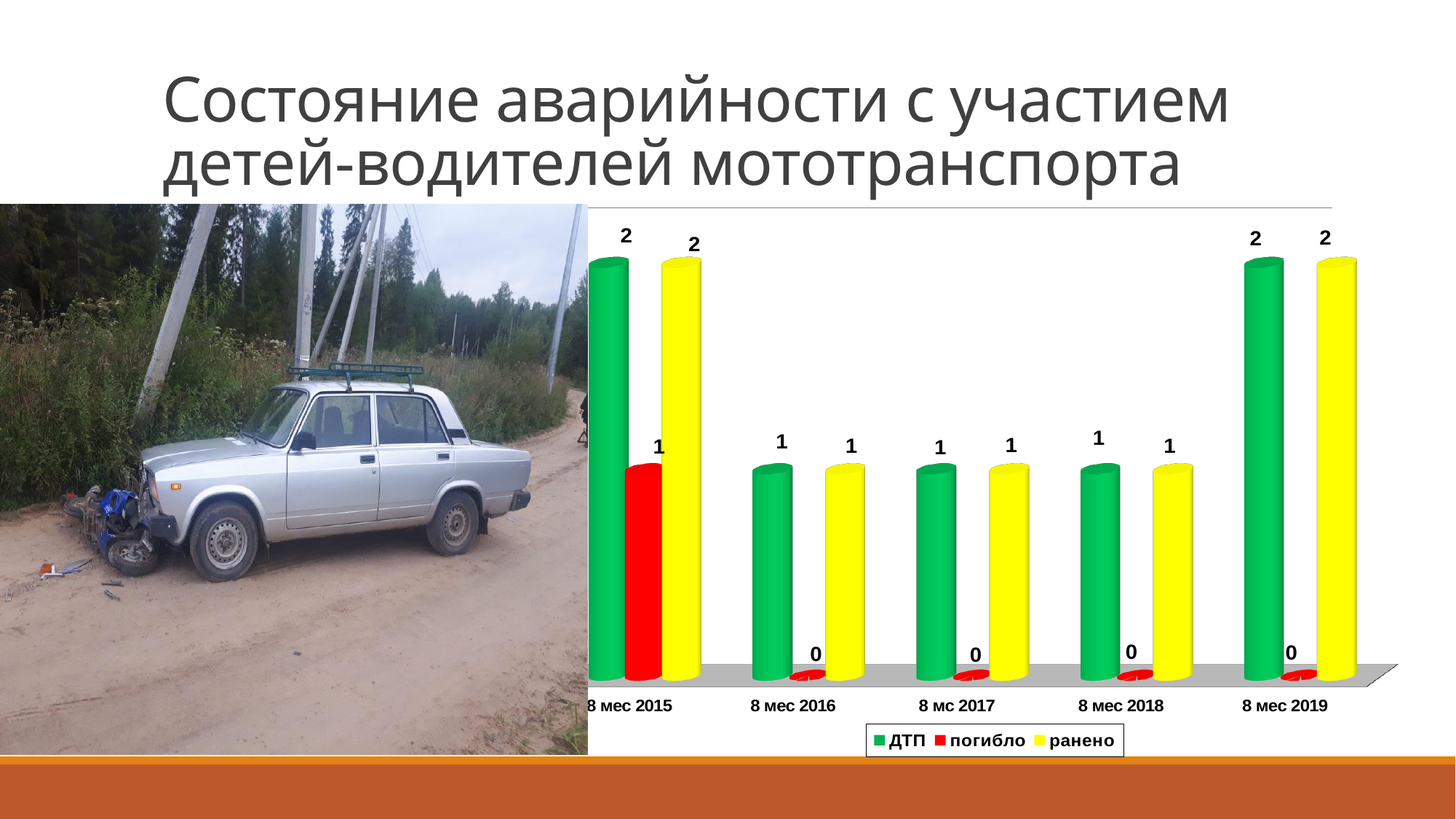
Which is larger: the ранено value for 8 мес 2015 or the ранено value for 8 мес 2016? 8 мес 2015 What is the value of погибло for 8 мес 2015? 1 What is the value of ранено for 8 мес 2019? 2 How many series does the legend list? 3 What is the value of погибло for 8 мес 2018? 0 What is the value of ДТП for 8 мес 2015? 2 What is the value of ДТП for 8 мс 2017? 1 In which category is the погибло value highest? 8 мес 2015 What kind of chart is shown on the slide? Bar chart Which colour represents the ранено series in the legend? Yellow How many categories are shown on the x axis? 5 What is the difference between the ДТП value for 8 мес 2019 and the ДТП value for 8 мес 2018? 1